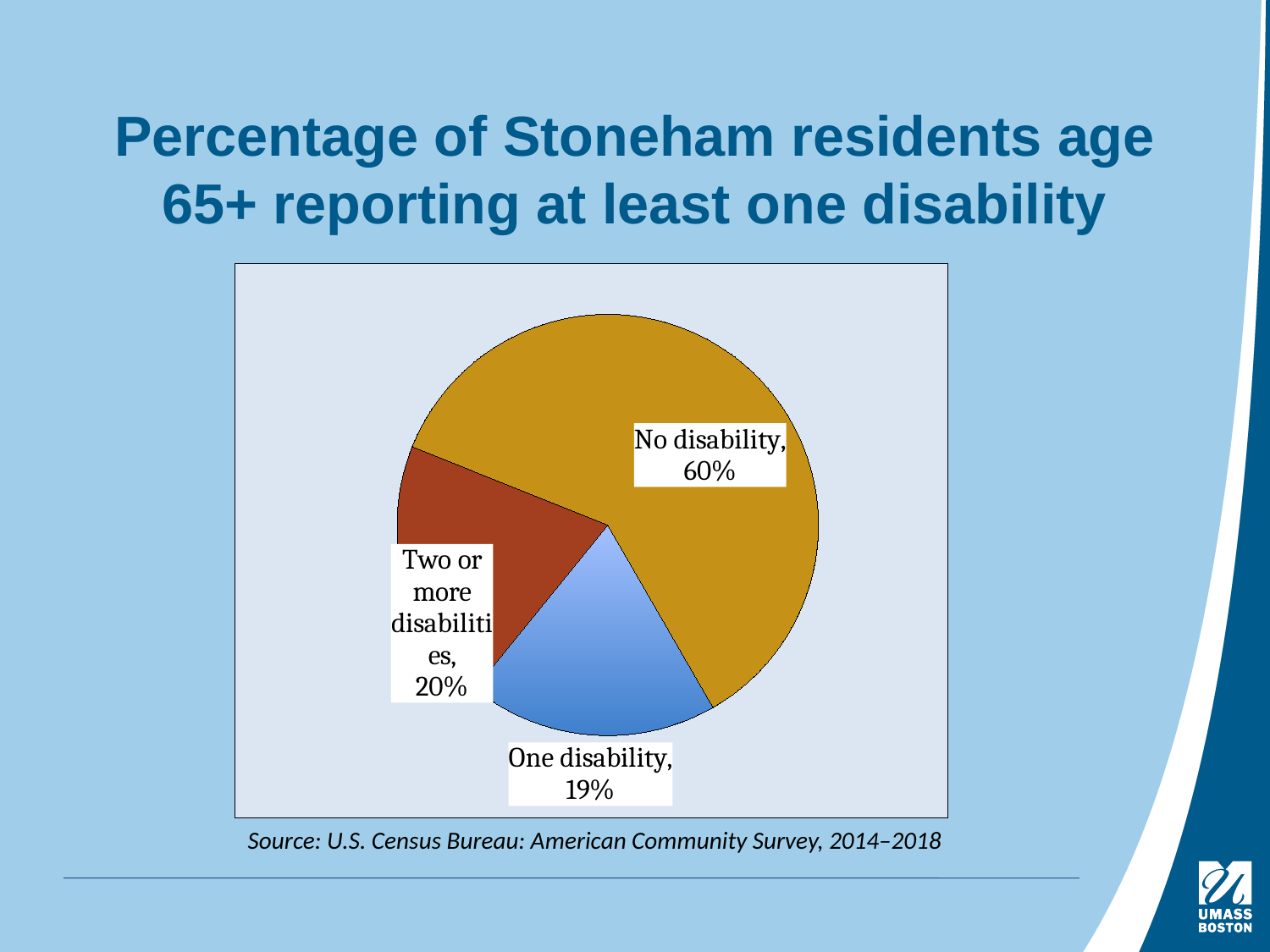
What is the difference in percentage points between the 'No disability' slice and the 'Two or more disabilities' slice? 40 What kind of chart is shown on the slide? pie chart What percentage of Stoneham residents age 65+ report two or more disabilities? 20% What data source is cited below the chart? U.S. Census Bureau: American Community Survey, 2014–2018 What percentage of Stoneham residents age 65+ report no disability? 60% What colour is the 'No disability' slice? gold Which category has the smallest share of the pie? One disability Which category has the largest share of the pie? No disability What is the difference in percentage points between the 'Two or more disabilities' slice and the 'One disability' slice? 1 How many slices does the pie chart have? 3 Which is larger: the share for 'No disability' or the share for 'One disability'? No disability What percentage of Stoneham residents age 65+ report one disability? 19%